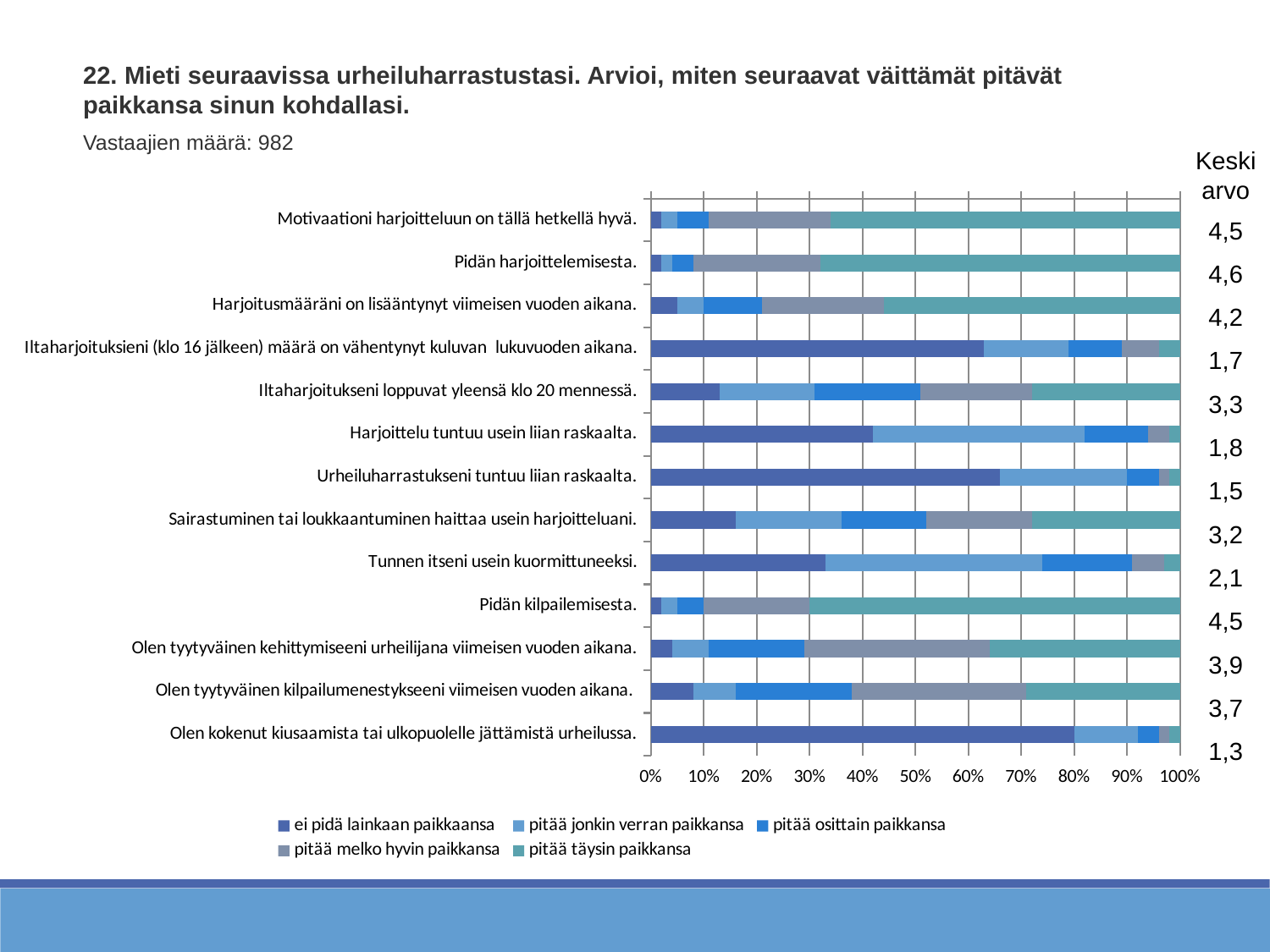
Is the "pitää täysin paikkansa" share for "Pidän harjoittelemisesta." greater or less than 60%? greater Which has a higher Keskiarvo (mean): "Harjoitusmääräni on lisääntynyt viimeisen vuoden aikana." or "Olen tyytyväinen kilpailumenestykseeni viimeisen vuoden aikana."? Harjoitusmääräni on lisääntynyt viimeisen vuoden aikana. What is the Keskiarvo (mean) shown for "Pidän harjoittelemisesta."? 4,6 What kind of chart is shown on the slide? stacked bar chart Which statement has the highest Keskiarvo (mean) value? Pidän harjoittelemisesta. Is the "ei pidä lainkaan paikkaansa" share for "Olen kokenut kiusaamista tai ulkopuolelle jättämistä urheilussa." greater or less than 70%? greater What is the Keskiarvo (mean) shown for "Sairastuminen tai loukkaantuminen haittaa usein harjoitteluani."? 3,2 How many series does the legend list? 5 How many respondents (Vastaajien määrä) does the slide report? 982 How many statements (categories) are plotted in the chart? 13 What is the Keskiarvo (mean) shown for "Olen kokenut kiusaamista tai ulkopuolelle jättämistä urheilussa."? 1,3 Which statement has the lowest Keskiarvo (mean) value? Olen kokenut kiusaamista tai ulkopuolelle jättämistä urheilussa.